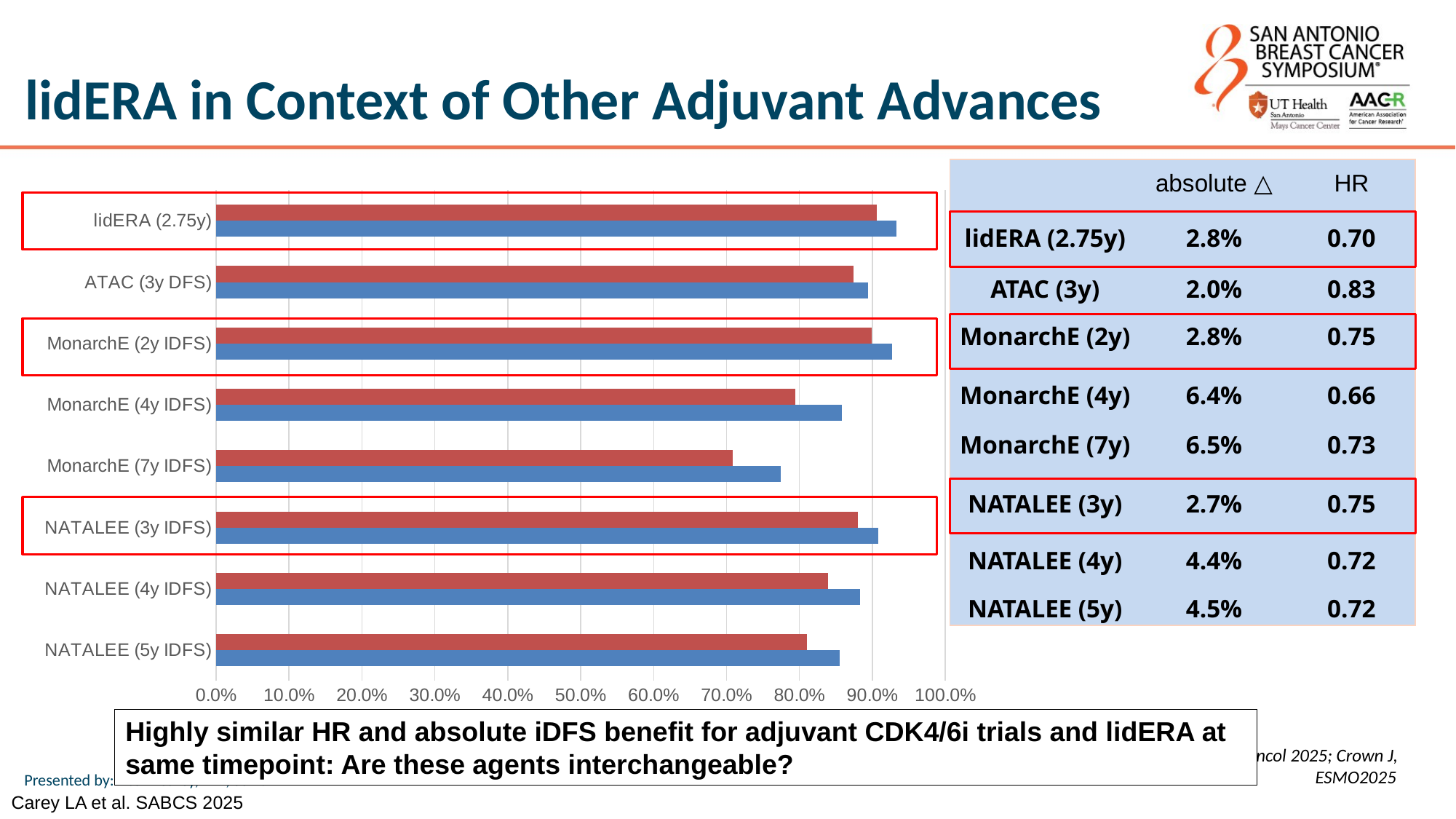
How many trial categories are plotted on the bar chart? 8 Which has the larger red bar, lidERA (2.75y) or NATALEE (5y IDFS)? lidERA (2.75y) Which category has the lowest red bar on the chart? MonarchE (7y IDFS) What is the maximum value shown on the x axis of the bar chart? 100.0% Is the blue bar for lidERA (2.75y) greater or less than 90.0%? greater Which category has the lowest blue bar on the chart? MonarchE (7y IDFS) What kind of chart is shown on the slide? bar chart Is the blue bar for MonarchE (7y IDFS) greater or less than 80.0%? less Which has the larger blue bar, MonarchE (2y IDFS) or MonarchE (7y IDFS)? MonarchE (2y IDFS) Is the blue bar for MonarchE (4y IDFS) greater or less than 80.0%? greater How many bars are shown for each category on the bar chart? 2